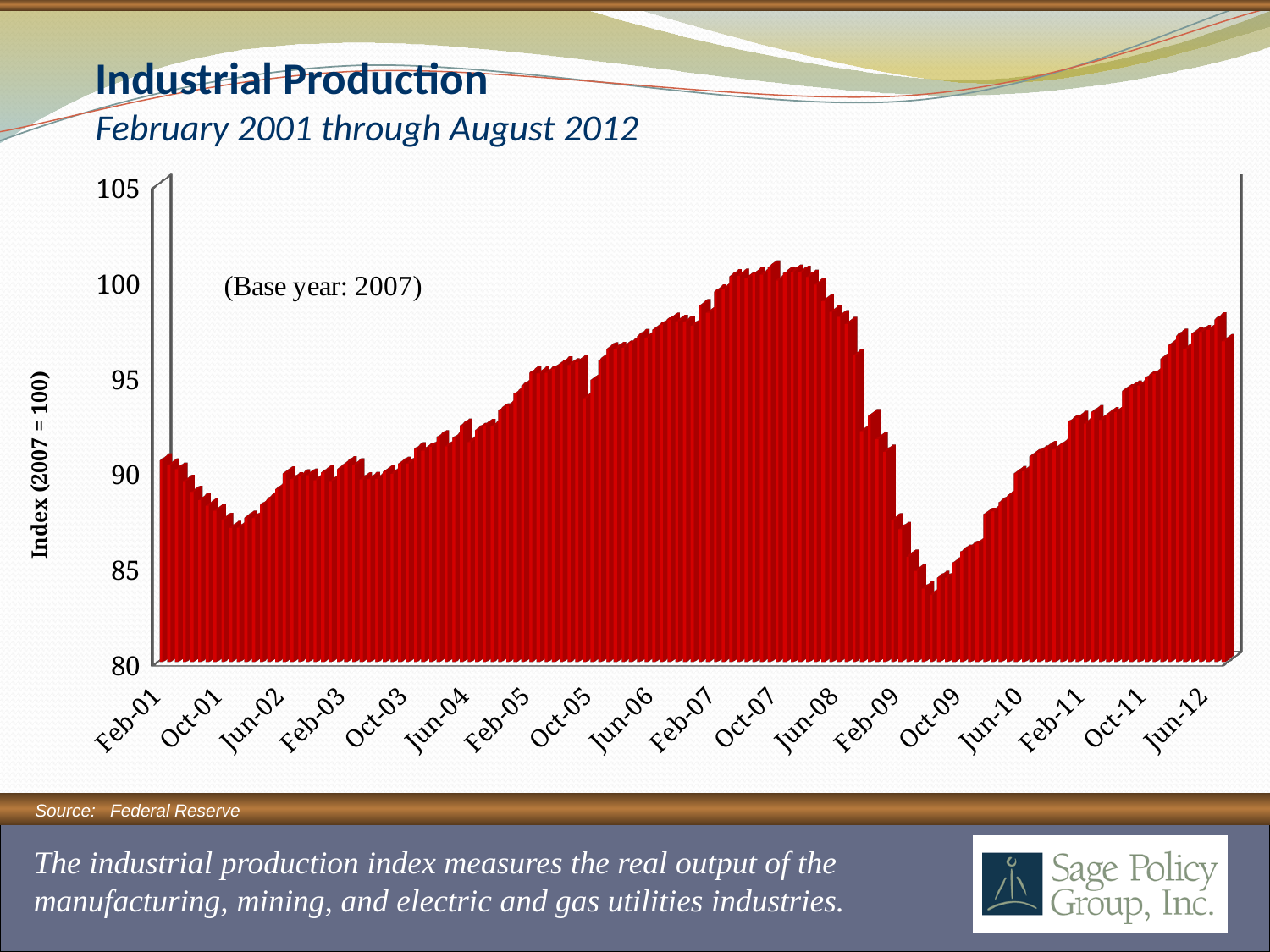
What kind of chart is shown on the slide? bar chart Do the values rise or fall between Jun-08 and Feb-09? fall Do the values rise or fall between Oct-09 and Jun-12? rise Is the value for Feb-09 greater or less than 90? less Is the value for Jun-12 greater or less than 95? greater What is the label on the vertical axis of the chart? Index (2007 = 100) Is the value for Oct-09 greater or less than 90? less What is the title of the chart on the slide? Industrial Production Which is larger, the value for Oct-07 or the value for Oct-09? Oct-07 Which is larger, the value for Feb-01 or the value for Jun-12? Jun-12